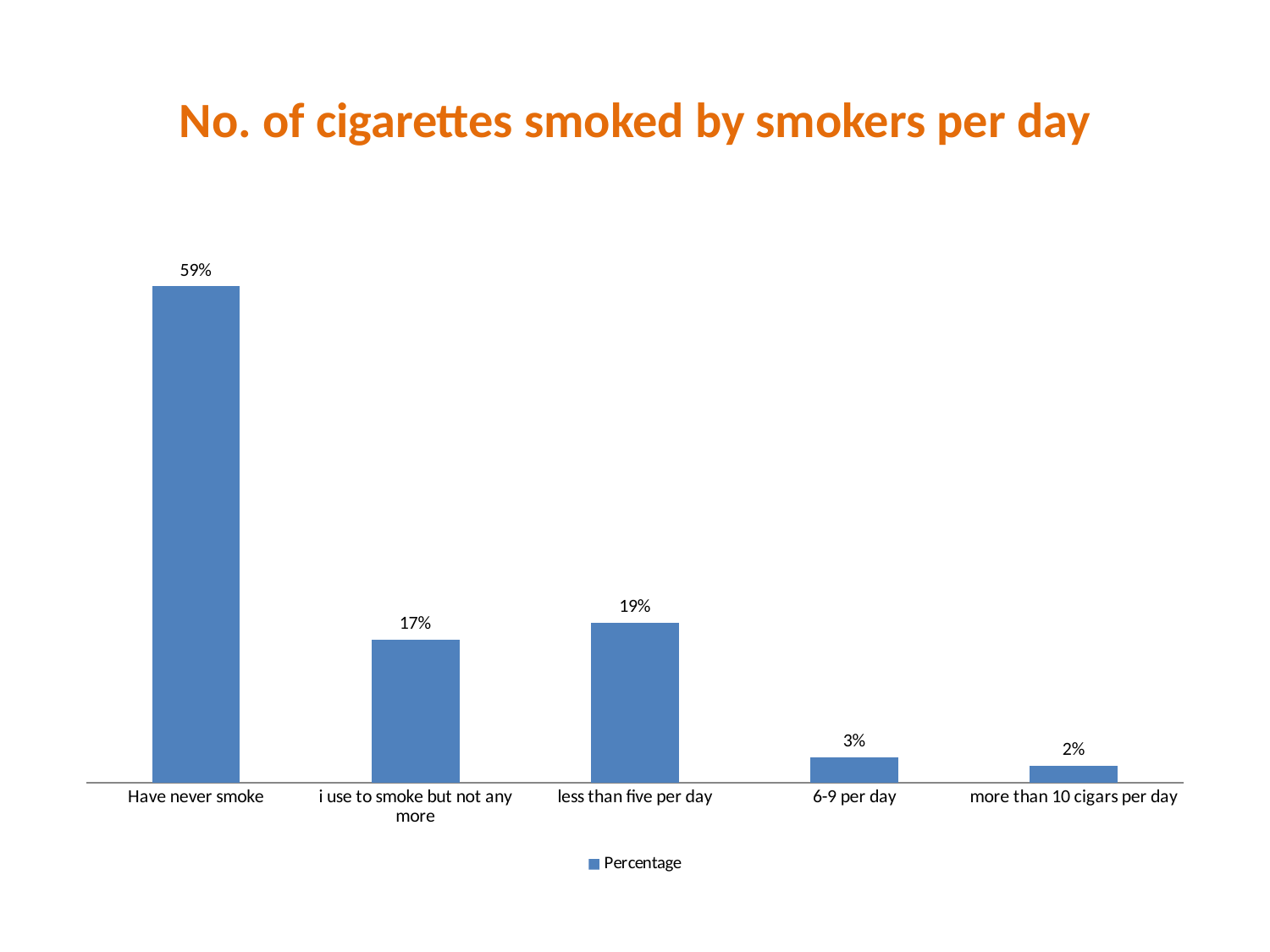
What is the difference between "Have never smoke" and "less than five per day"? 40% What kind of chart is this? bar chart What percentage is shown for "6-9 per day"? 3% What series name does the legend show? Percentage How many categories are shown on the x axis? 5 Which category has the highest percentage? Have never smoke What percentage is shown for "Have never smoke"? 59% What is the value for "less than five per day"? 19% Which is larger, "i use to smoke but not any more" or "6-9 per day"? i use to smoke but not any more Which category has the lowest percentage? more than 10 cigars per day What is the value for "more than 10 cigars per day"? 2% What is the difference between "less than five per day" and "i use to smoke but not any more"? 2%